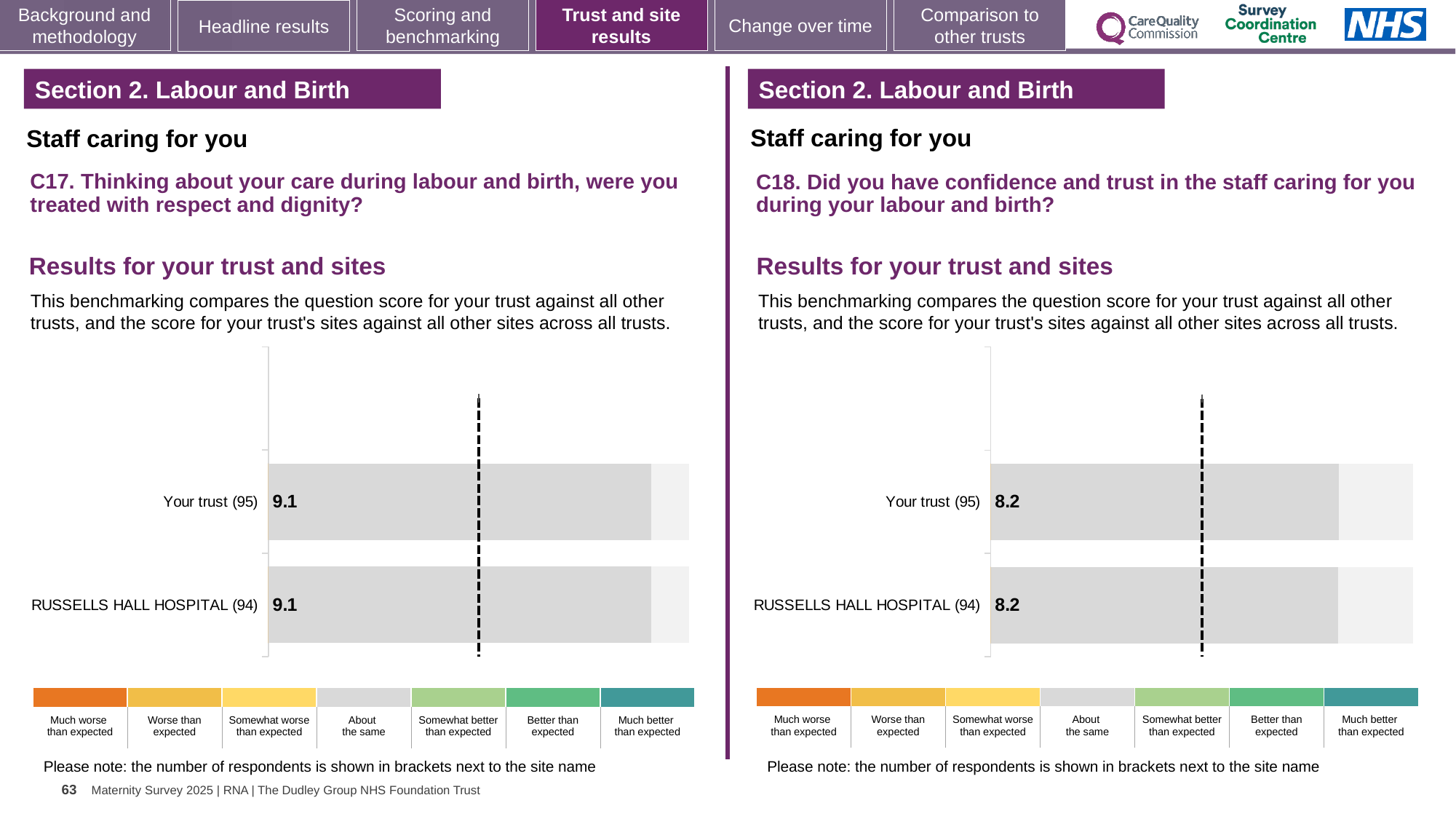
On the left chart (C17), what is the score for RUSSELLS HALL HOSPITAL? 9.1 On the right chart (C18), what is the difference between the Your trust score and the RUSSELLS HALL HOSPITAL score? 0.0 On the right chart (C18), how many respondents are shown in brackets for RUSSELLS HALL HOSPITAL? 94 What kind of chart is used on the left (C17)? Bar chart How many bars are plotted on the right chart (C18)? 2 On the right chart (C18), what is the score for RUSSELLS HALL HOSPITAL? 8.2 On the left chart (C17), what is the difference between the Your trust score and the RUSSELLS HALL HOSPITAL score? 0.0 On the right chart (C18), what is the score for Your trust? 8.2 On the left chart (C17), what is the score for Your trust? 9.1 On the left chart (C17), how many respondents are shown in brackets for Your trust? 95 How many bars are plotted on the left chart (C17)? 2 Is the Your trust score on the left chart (C17) larger or smaller than the Your trust score on the right chart (C18)? Larger